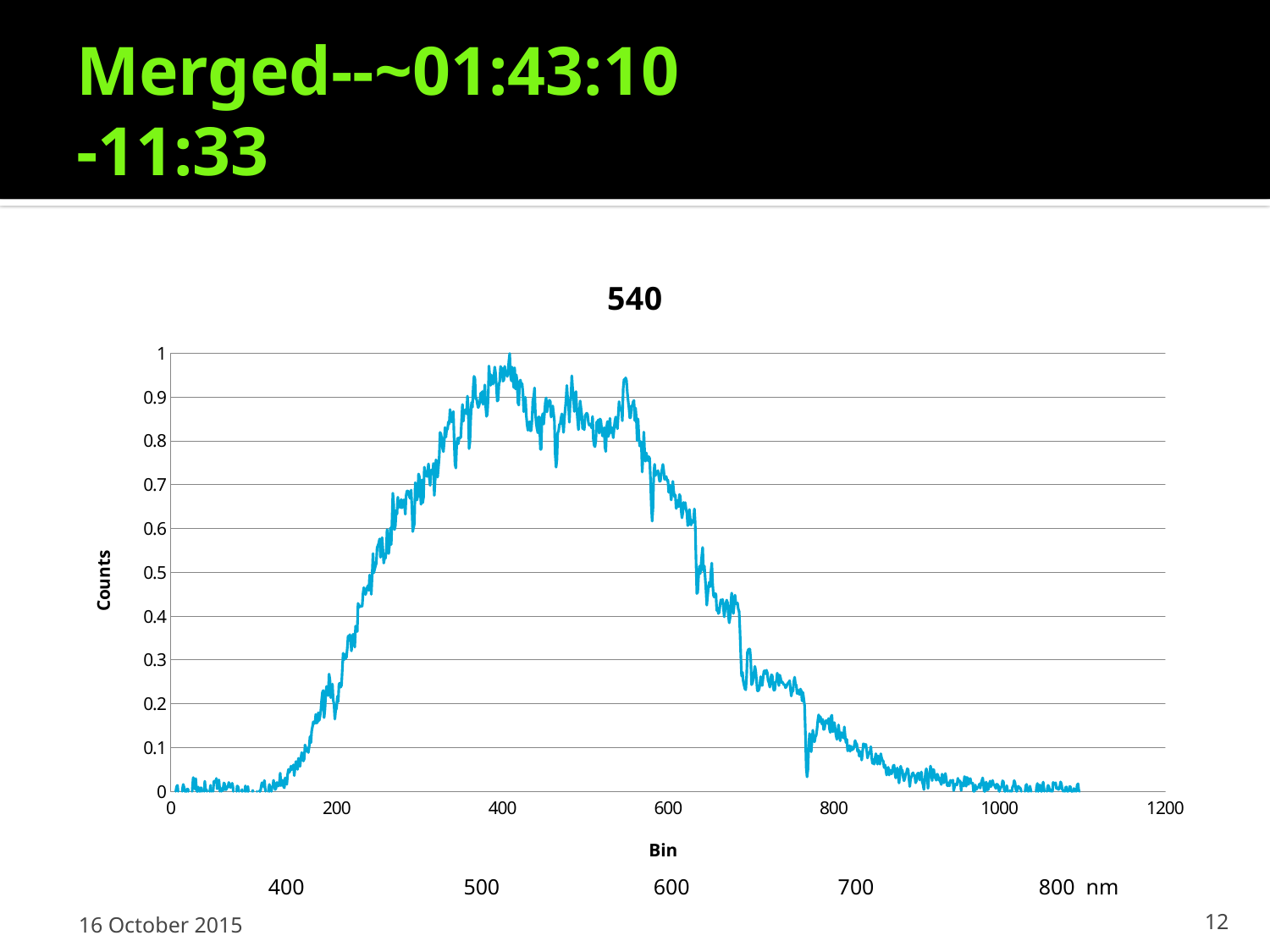
Is the value for Bin 800 greater or less than 0.3? less Do the values rise or fall along the x axis between Bin 600 and Bin 1000? fall Is the value for Bin 400 greater or less than 0.9? greater Is the value for Bin 600 greater or less than 0.5? greater Do the values rise or fall along the x axis between Bin 100 and Bin 400? rise What kind of chart is shown on the slide? line chart What is the label of the vertical axis of the chart? Counts Which has the larger value, Bin 400 or Bin 800? Bin 400 What is the title of the chart? 540